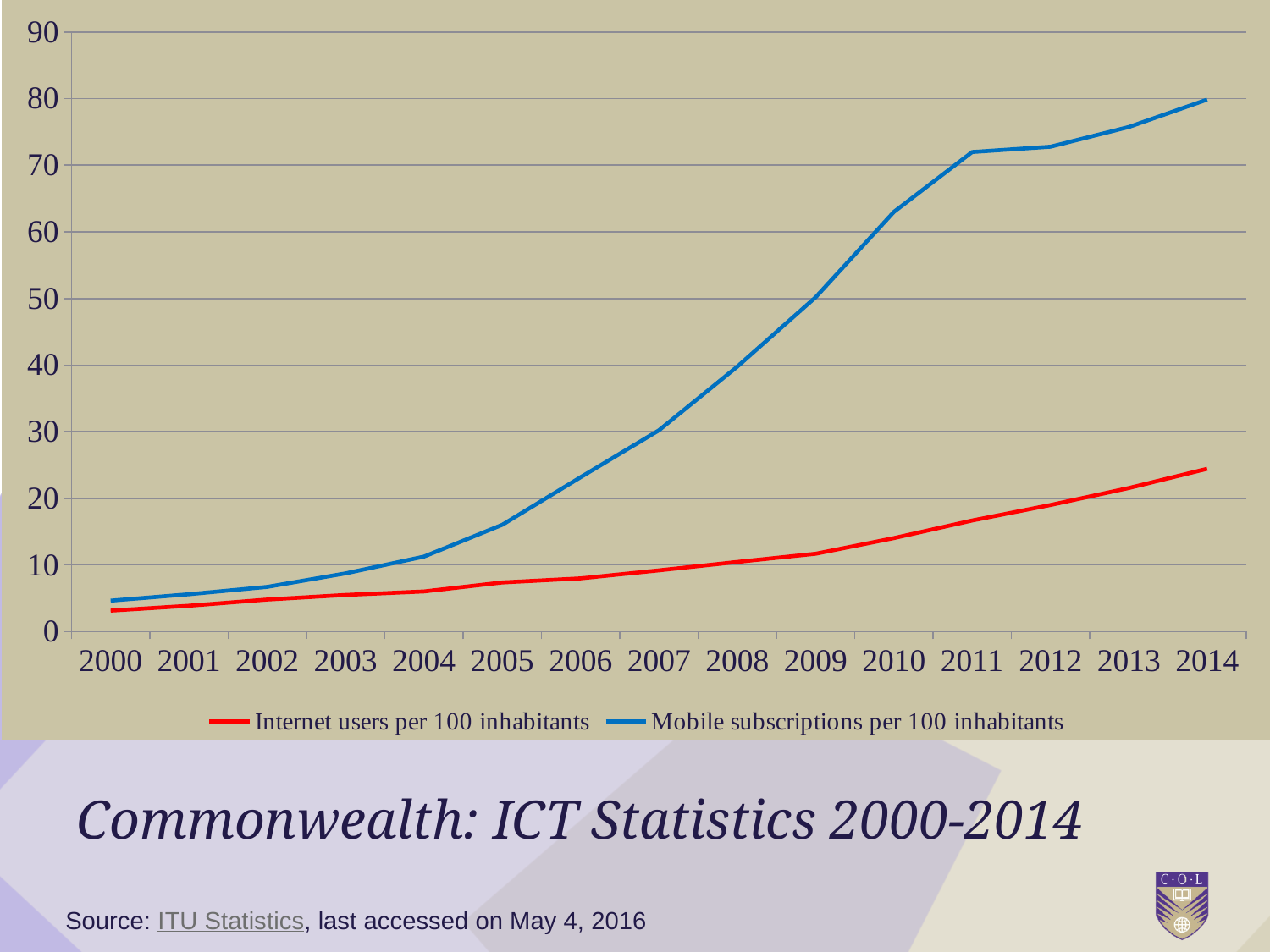
Is the value for Mobile subscriptions per 100 inhabitants in 2005 greater or less than 20? less How many years are plotted along the x axis? 15 Is the value for Mobile subscriptions per 100 inhabitants in 2011 greater or less than 70? greater In which year is Mobile subscriptions per 100 inhabitants highest? 2014 Do the values for Mobile subscriptions per 100 inhabitants rise or fall from 2000 to 2014? rise Do the values for Internet users per 100 inhabitants rise or fall from 2000 to 2014? rise Is the value for Internet users per 100 inhabitants in 2014 greater or less than 20? greater How many series does the legend list? 2 In 2014, which is larger: Internet users per 100 inhabitants or Mobile subscriptions per 100 inhabitants? Mobile subscriptions per 100 inhabitants Which colour is used for the Internet users per 100 inhabitants line? red What kind of chart is shown on the slide? line chart